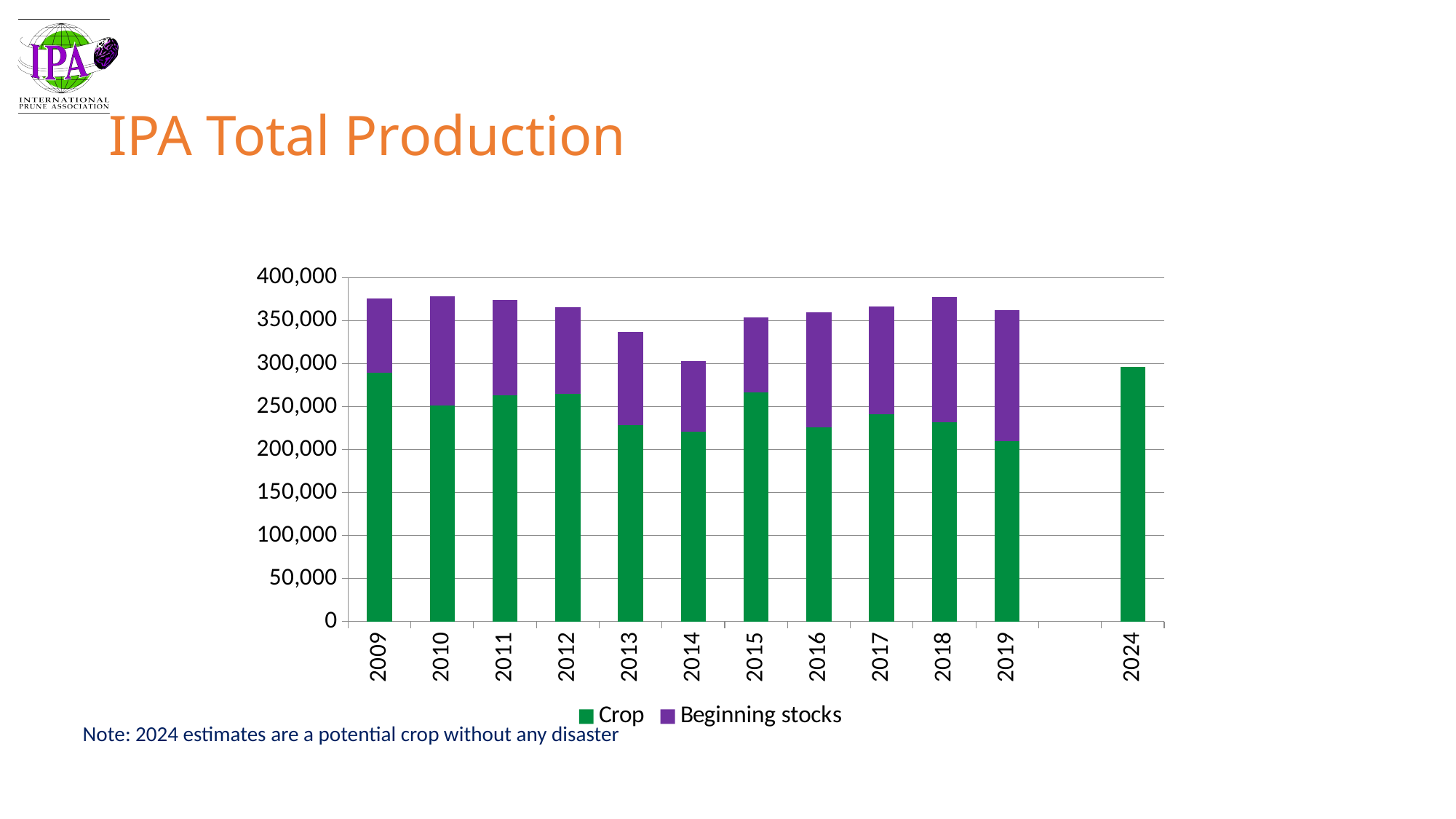
How many years are shown on the x axis? 12 Is the total for 2010 greater or less than 350,000? greater Which year has the lowest total bar? 2024 Which year shows only a Crop segment with no Beginning stocks segment? 2024 Is the total for 2014 greater or less than 350,000? less Which is larger, the Crop value for 2009 or the Crop value for 2010? 2009 What is the title of the slide's chart? IPA Total Production Is the Crop value for 2019 greater or less than 250,000? less What kind of chart is shown on the slide? Stacked bar chart How many series does the legend list? 2 Which is larger, the total bar for 2014 or the total bar for 2015? 2015